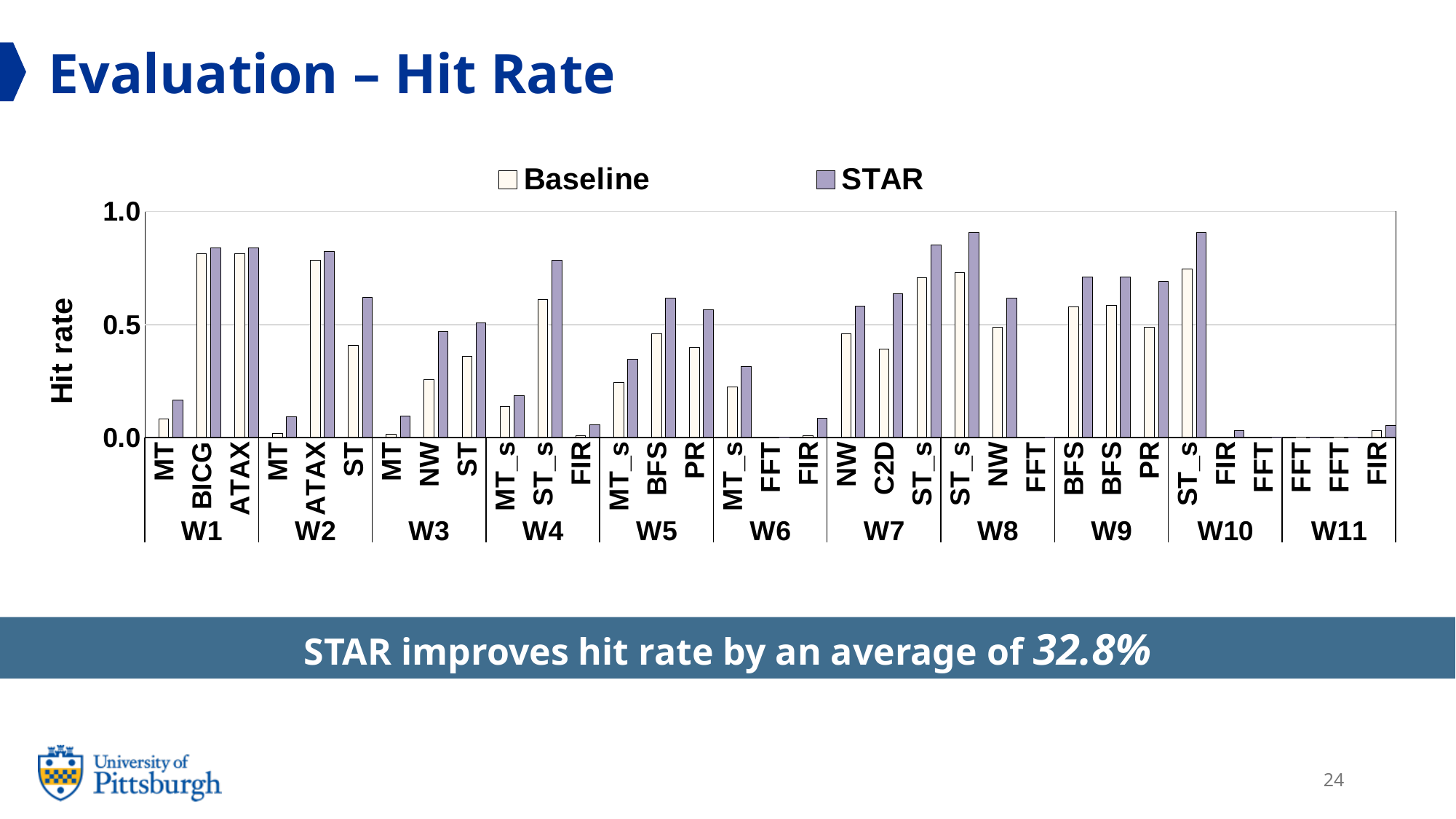
Is the STAR value for BICG in W1 greater or less than 0.5? greater How many benchmark categories are plotted in total along the x axis? 33 For ST_s in W4, which is larger, the Baseline value or the STAR value? STAR What are the two series named in the legend? Baseline and STAR Is the STAR value for ST_s in W8 greater or less than 0.5? greater Is the Baseline value for C2D in W7 greater or less than 0.5? less What is the label of the y axis? Hit rate For MT in W1, which is larger, the Baseline value or the STAR value? STAR What kind of chart is shown on the slide? bar chart How many series does the legend list? 2 How many workload groups (W1, W2, ...) are shown along the x axis? 11